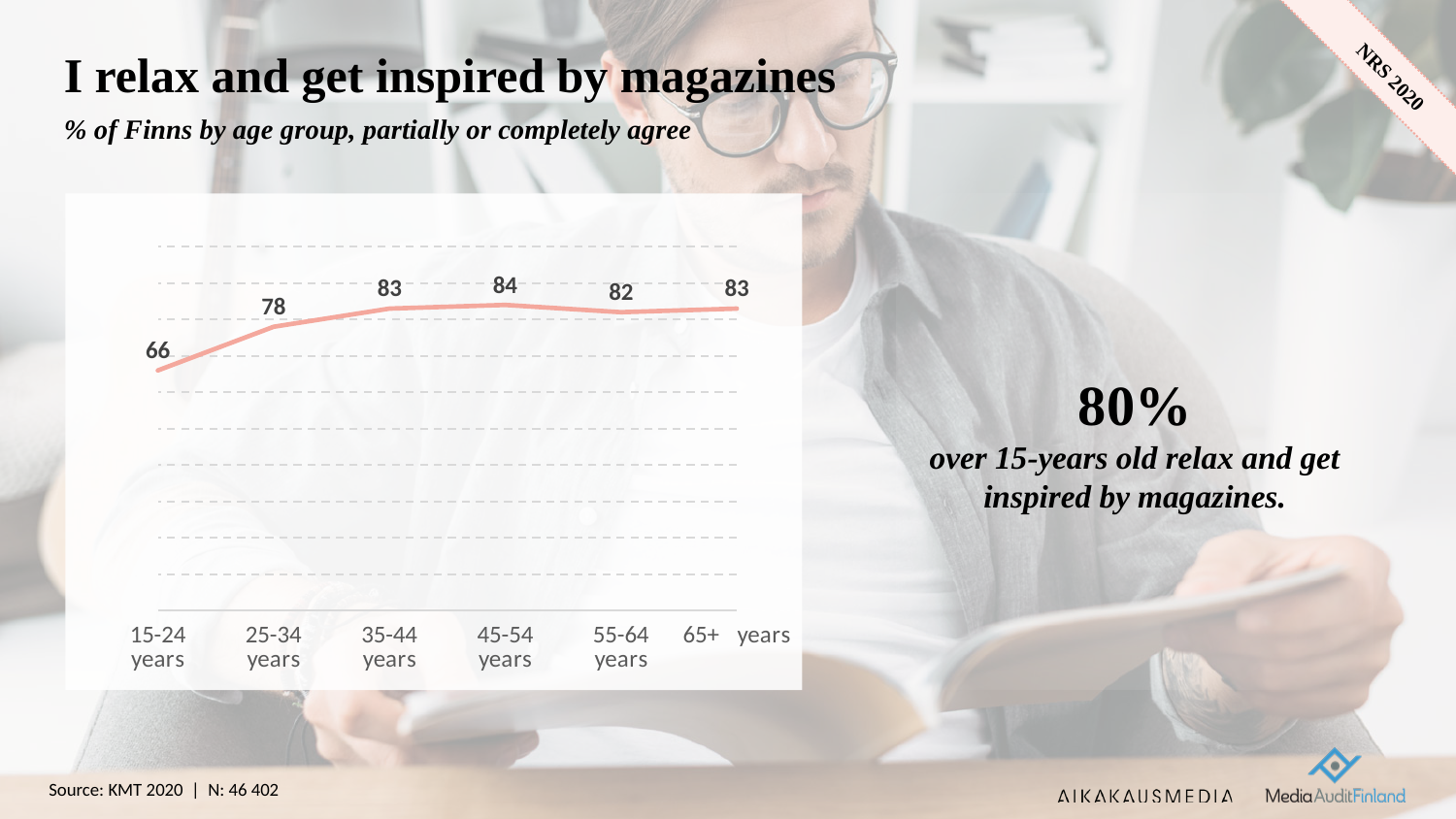
What is the title of the chart? I relax and get inspired by magazines Which age group has the highest value? 45-54 years What is the value for the 65+ years age group? 83 What is the value for the 45-54 years age group? 84 How many age groups are plotted on the chart? 6 Does the value rise or fall from 15-24 years to 25-34 years? rise What kind of chart is shown on the slide? line chart Which is larger, the value for 35-44 years or the value for 55-64 years? 35-44 years Which age group has the lowest value? 15-24 years What is the difference between the values for 45-54 years and 55-64 years? 2 What is the value for the 15-24 years age group? 66 What is the difference between the values for 25-34 years and 15-24 years? 12